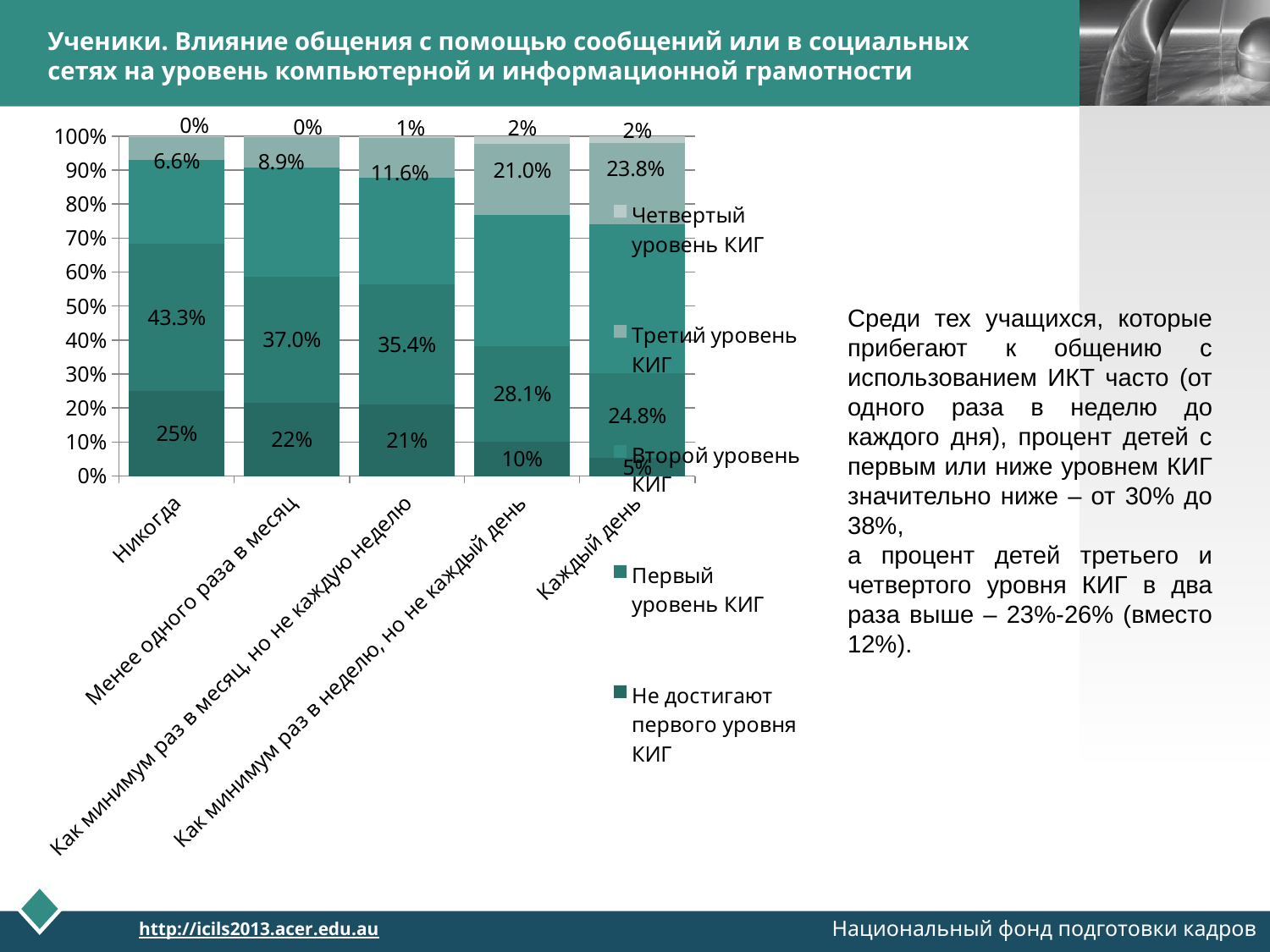
Which is larger: the 'Третий уровень КИГ' value for 'Каждый день' or for 'Никогда'? Каждый день What is the value of 'Четвертый уровень КИГ' for the category 'Как минимум раз в месяц, но не каждую неделю'? 1% What is the value of 'Третий уровень КИГ' for the category 'Как минимум раз в неделю, но не каждый день'? 21.0% What is the value of 'Не достигают первого уровня КИГ' for the category 'Никогда'? 25% Do the values for 'Не достигают первого уровня КИГ' rise or fall from 'Никогда' to 'Каждый день'? fall What kind of chart is shown on the slide? bar chart How many series does the legend list? 5 What is the value of 'Первый уровень КИГ' for the category 'Каждый день'? 24.8% Which category has the highest value for 'Первый уровень КИГ'? Никогда Which category has the lowest value for 'Не достигают первого уровня КИГ'? Каждый день What is the difference between the 'Первый уровень КИГ' values for 'Никогда' and 'Менее одного раза в месяц'? 6.3% How many categories are shown along the x axis? 5